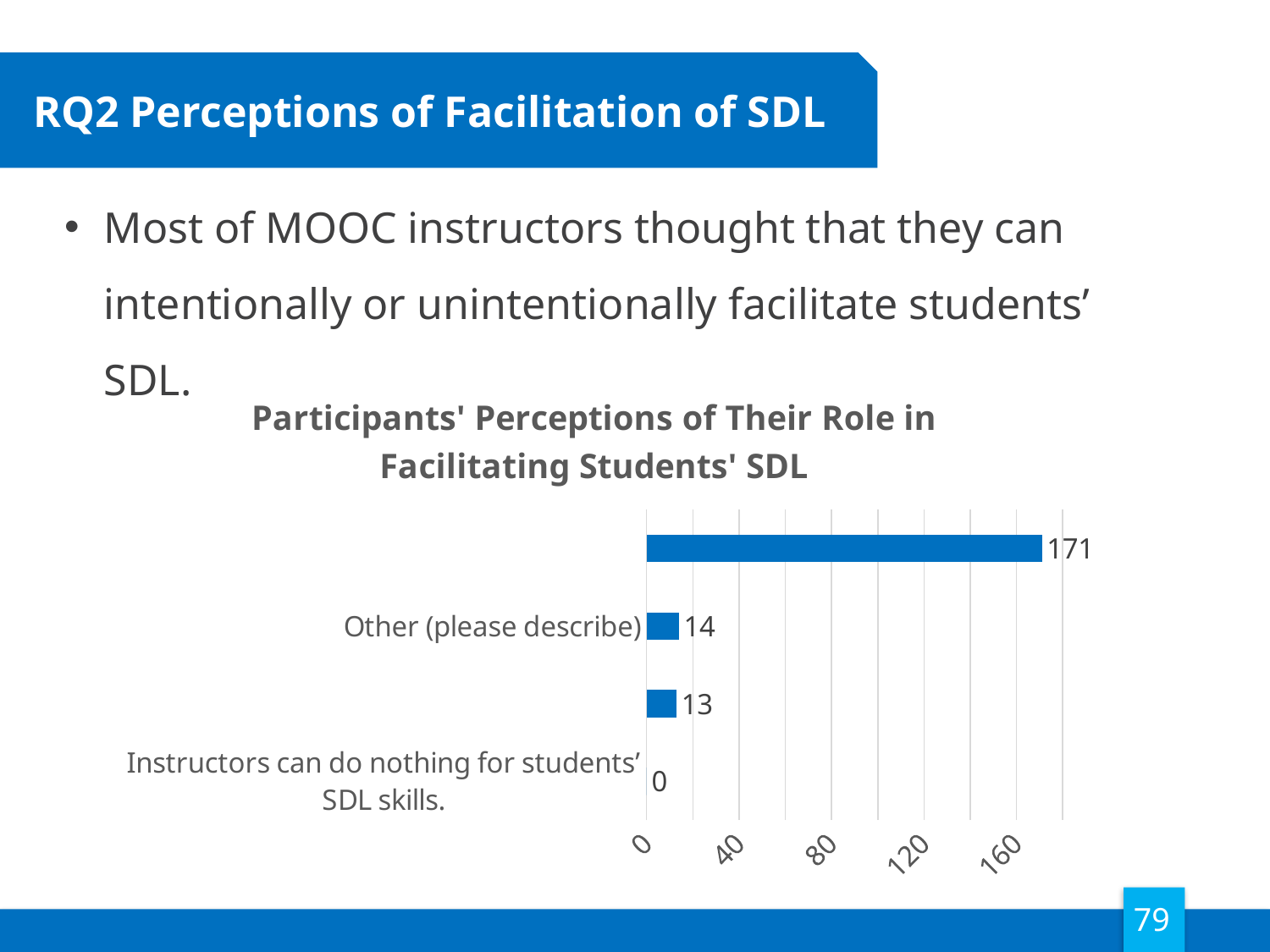
Which category has the lowest value in the chart? Instructors can do nothing for students' SDL skills. What is the value for "Other (please describe)"? 14 What type of chart is shown on the slide? bar chart What is the highest tick label shown on the horizontal axis? 160 What is the difference between the value for "Other (please describe)" and the value for "Instructors can do nothing for students' SDL skills."? 14 What is the title of the chart? Participants' Perceptions of Their Role in Facilitating Students' SDL What is the value for "Instructors can do nothing for students' SDL skills."? 0 What is the largest value shown in the chart? 171 Which is larger: the value for "Other (please describe)" or the value for "Instructors can do nothing for students' SDL skills."? Other (please describe) Is the value for "Other (please describe)" greater or less than 40? less